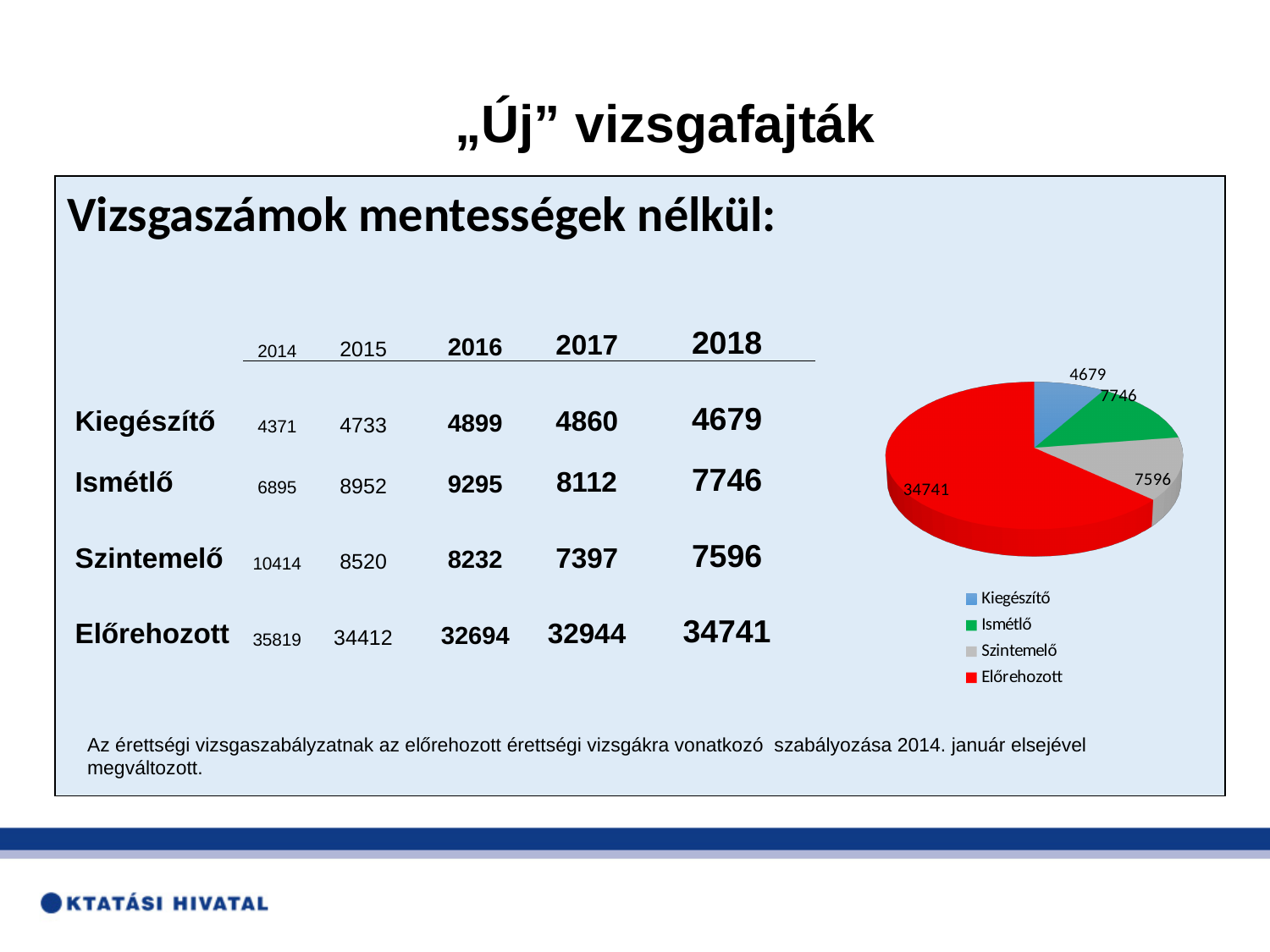
What colour is the Előrehozott slice in the pie chart? red How many slices does the pie chart have? 4 In the pie chart, what is the difference between the values for Előrehozott and Kiegészítő? 30062 In the pie chart, what is the value for Kiegészítő? 4679 Which category has the largest slice in the pie chart? Előrehozott Which category has the smallest slice in the pie chart? Kiegészítő In the pie chart, what is the value for Szintemelő? 7596 What kind of chart is shown on the slide? pie chart In the pie chart, what is the value for Előrehozott? 34741 In the pie chart, which is larger, Ismétlő or Szintemelő? Ismétlő In the pie chart, what is the difference between the values for Ismétlő and Szintemelő? 150 In the pie chart, what is the value for Ismétlő? 7746